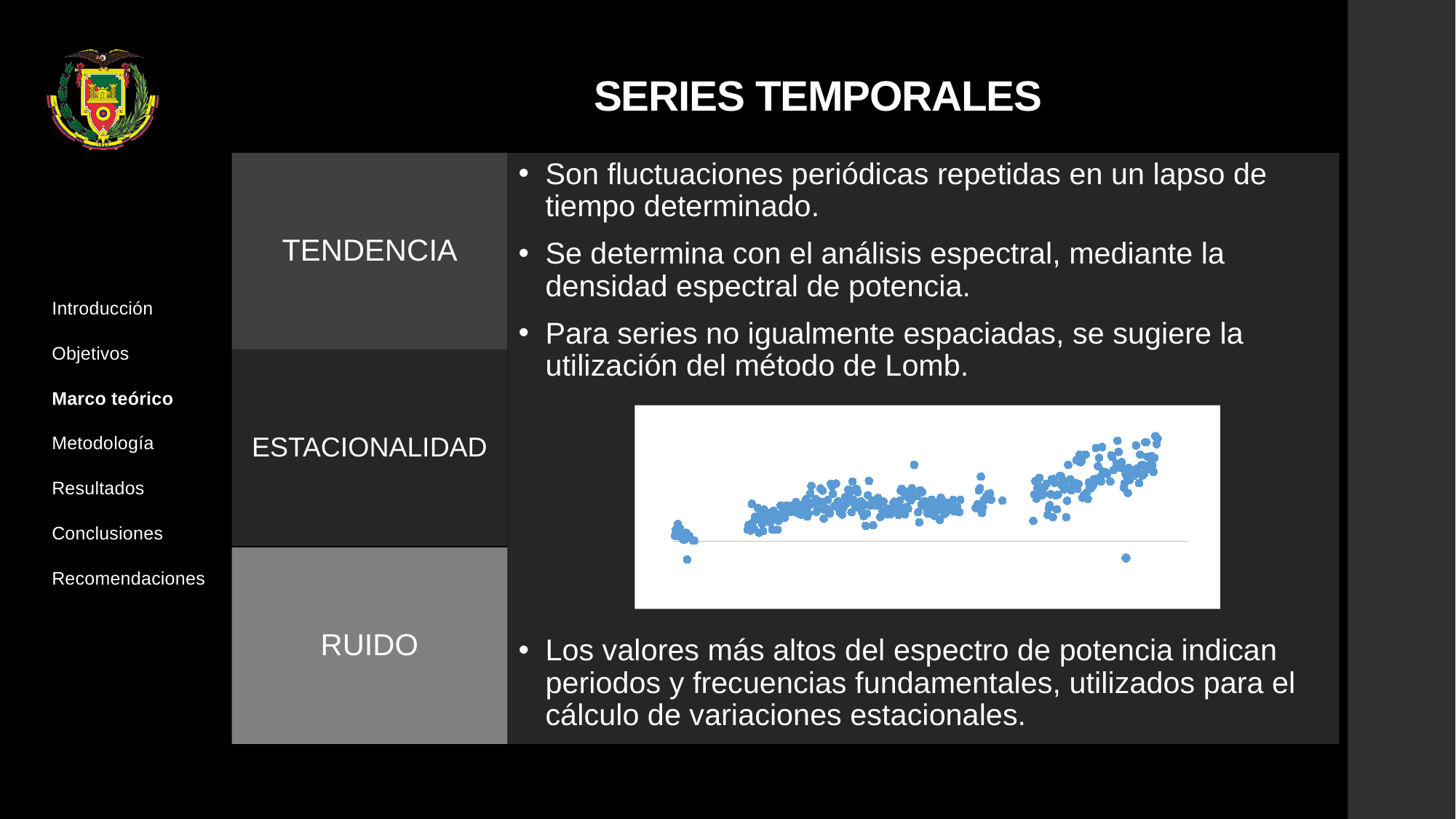
What kind of chart is shown on the slide? scatter chart What colour are the plotted points in the scatter chart? blue Do the plotted points generally rise or fall from left to right along the x axis? rise Does the scatter chart display a legend? no